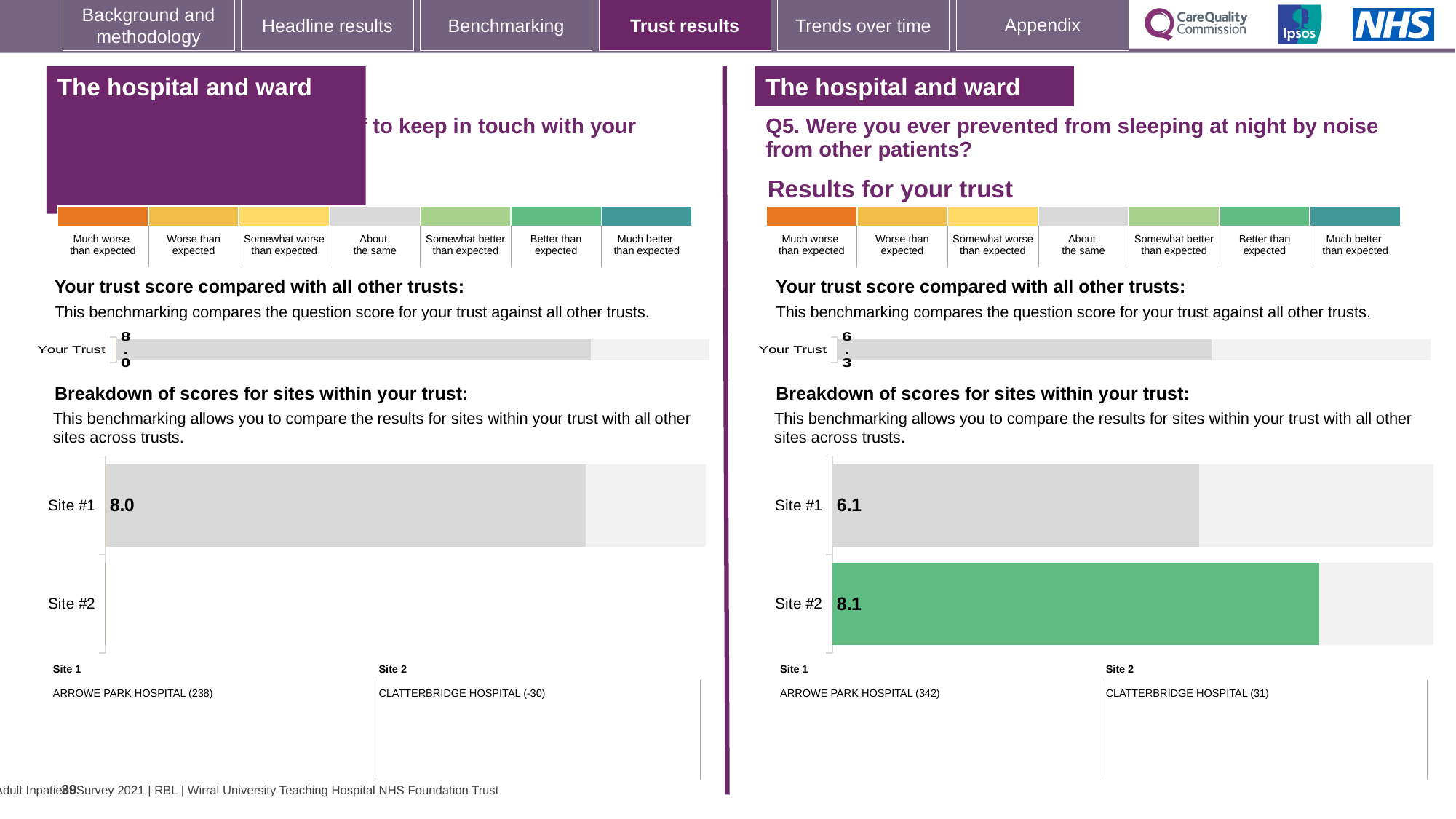
How many sites are listed on the right-hand site breakdown chart (Q5)? 2 On the right-hand chart (Q5, noise from other patients), what is the score for Site #1? 6.1 On the left-hand site breakdown chart, what is the score for Site #1? 8.0 On the right-hand chart (Q5, noise from other patients), what is the score for Site #2? 8.1 On the right-hand site breakdown chart (Q5), which site has the lower score? Site #1 On the right-hand site breakdown chart (Q5), what is the difference between the Site #2 and Site #1 scores? 2.0 On the right-hand site breakdown chart (Q5), which site's bar is coloured green? Site #2 What type of chart is used for the site breakdown on the right-hand side (Q5)? bar chart On the left-hand 'Your trust score compared with all other trusts' chart, what is the score shown for Your Trust? 8.0 On the right-hand 'Your trust score compared with all other trusts' chart (Q5), what is the score shown for Your Trust? 6.3 On the right-hand site breakdown chart (Q5), which site has the higher score? Site #2 On the right-hand site breakdown chart (Q5), is the score for Site #2 larger or smaller than the score for Site #1? larger